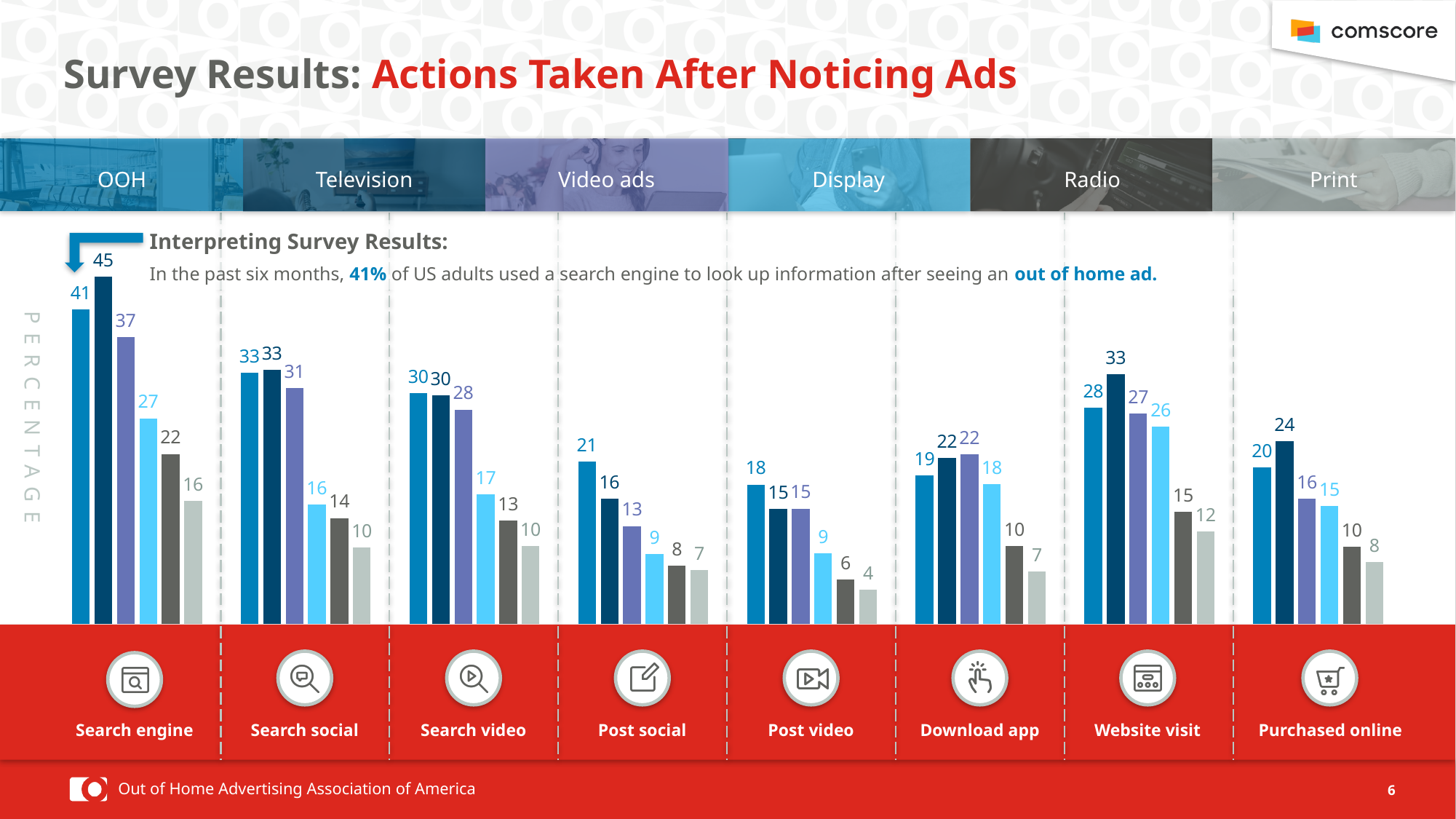
What is the difference between the Television and OOH values in the Search engine category? 4 What percentage of US adults used a search engine after seeing an out of home (OOH) ad? 41 How many media types (series) are shown in the header band above the chart? 6 In the Download app category, which is larger: the value for OOH or the value for Display? OOH What is the value for Print in the Post video category? 4 Which media type has the lowest value in the Purchased online category? Print What type of chart is shown on the slide? Bar chart Which media type has the highest value in the Search engine category? Television How many action categories are shown along the bottom of the chart? 8 What is the difference between the OOH and Radio values in the Post social category? 13 What is the value for Display in the Website visit category? 26 What is the value for Television in the Search engine category? 45